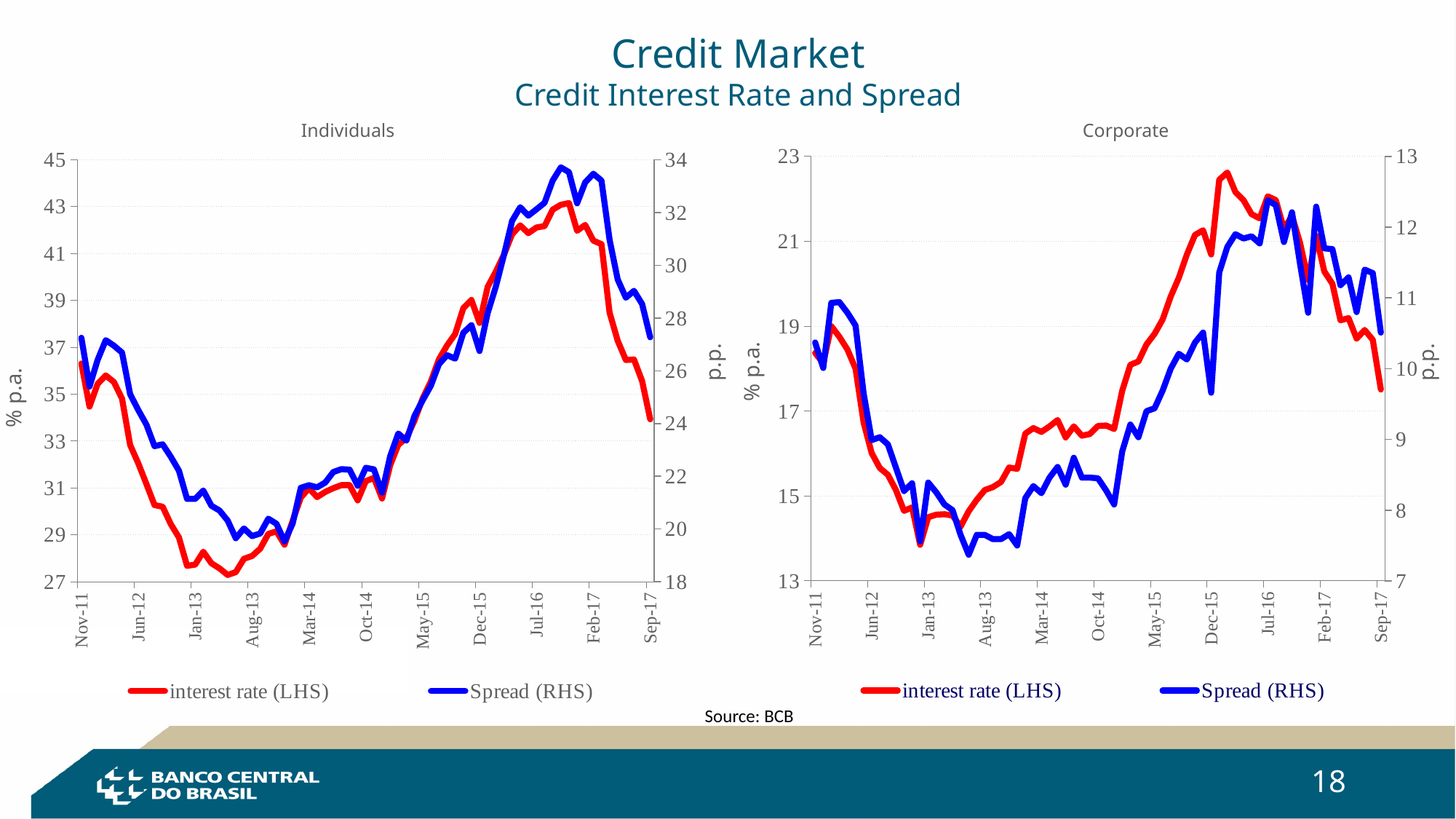
In the Corporate chart, is the interest rate (LHS) at Jan-13 greater or less than 15? less What source is cited for the charts on the slide? BCB In the Corporate chart, does the interest rate (LHS) rise or fall between Jan-13 and Dec-15? rise How many series does the legend of the Corporate chart list? 2 In the Individuals chart, is the interest rate (LHS) at Sep-17 greater or less than 35? less In the Individuals chart, does the interest rate (LHS) rise or fall between Nov-11 and Jan-13? fall In the Individuals chart, is the Spread (RHS) at Sep-17 greater or less than 26? greater In the Individuals chart, is the interest rate (LHS) higher at Nov-11 or at Sep-17? Nov-11 What kind of chart is the Individuals chart? line chart What is the label of the right-hand vertical axis on the Corporate chart? p.p.